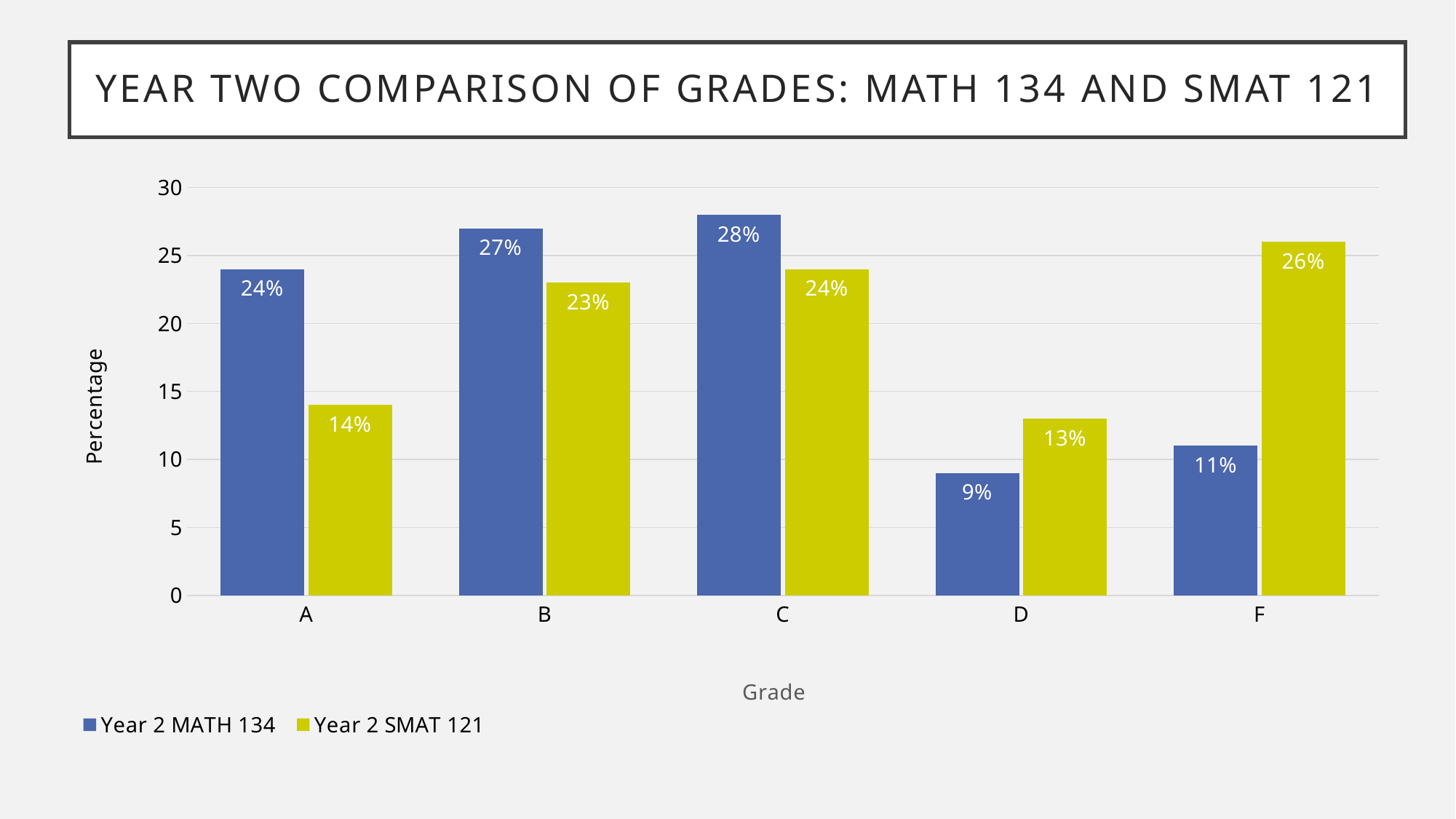
What is the label of the y axis? Percentage What kind of chart is shown on the slide? Bar chart Is the value for Year 2 MATH 134 at grade B greater or less than 25? greater Which grade has the highest percentage for Year 2 MATH 134? C How many series does the legend list? 2 Which grade has the lowest percentage for Year 2 SMAT 121? D How many grade categories are shown on the x axis? 5 What is the difference between the Year 2 MATH 134 and Year 2 SMAT 121 percentages at grade A? 10% At grade F, which series has the larger percentage, Year 2 MATH 134 or Year 2 SMAT 121? Year 2 SMAT 121 What percentage of Year 2 MATH 134 students received a grade of A? 24% What percentage of Year 2 SMAT 121 students received a grade of F? 26% What is the value for Year 2 SMAT 121 at grade D? 13%